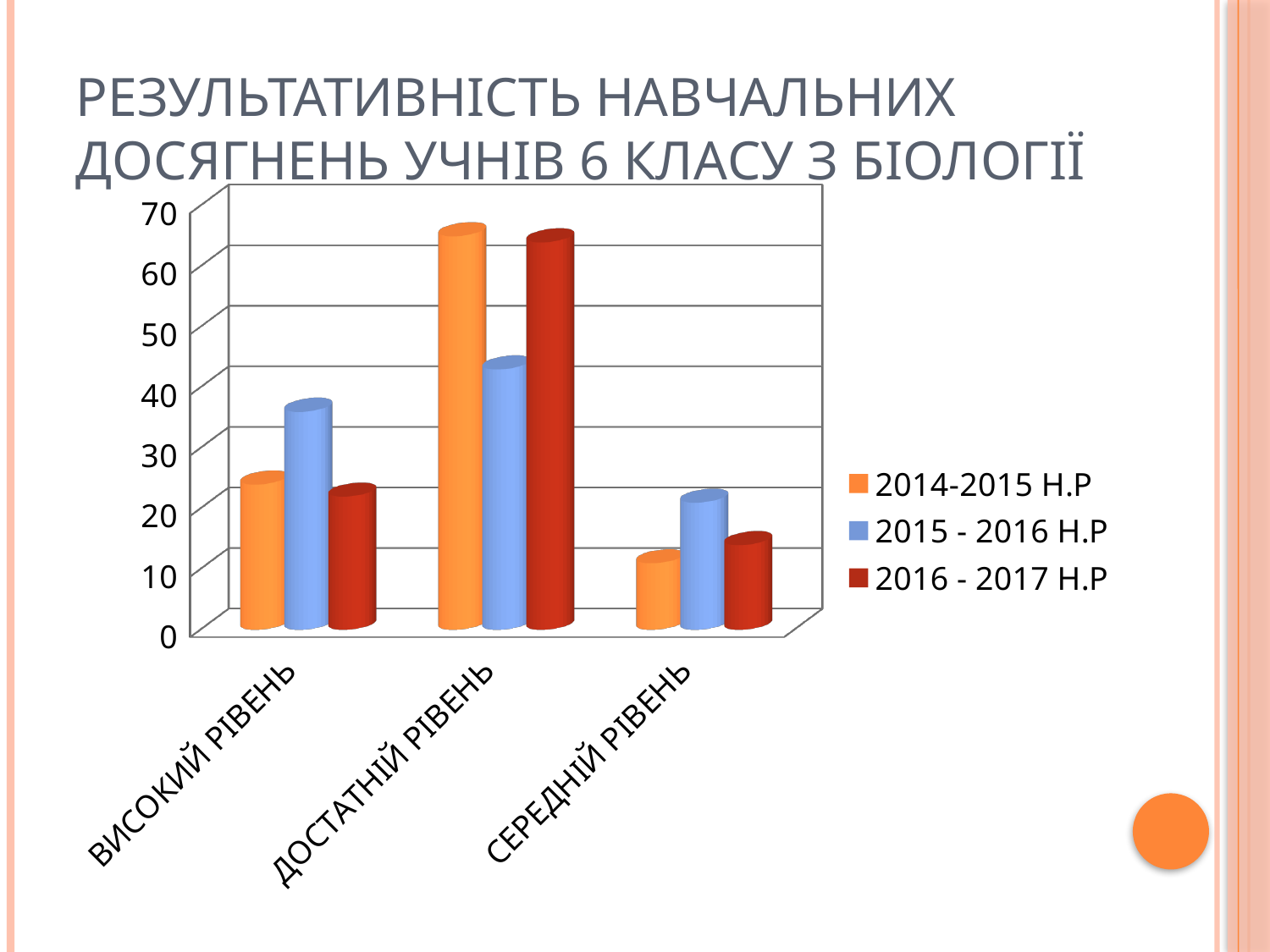
Which series is shown in blue in the chart's legend? 2015 - 2016 н.р Which category has the lowest value for the 2014-2015 н.р series? Середній рівень What kind of chart is shown on the slide? bar chart For Достатній рівень, which series has the larger value: 2014-2015 н.р or 2015 - 2016 н.р? 2014-2015 н.р How many categories are shown on the x axis of the chart? 3 Is the value for Достатній рівень in the 2015 - 2016 н.р series greater or less than 50? less How many series does the chart's legend list? 3 Is the value for Достатній рівень in the 2014-2015 н.р series greater or less than 60? greater For Високий рівень, which series has the larger value: 2014-2015 н.р or 2015 - 2016 н.р? 2015 - 2016 н.р Is the value for Середній рівень in the 2014-2015 н.р series greater or less than 20? less Which category has the highest value for the 2016 - 2017 н.р series? Достатній рівень Which category has the highest value for the 2014-2015 н.р series? Достатній рівень